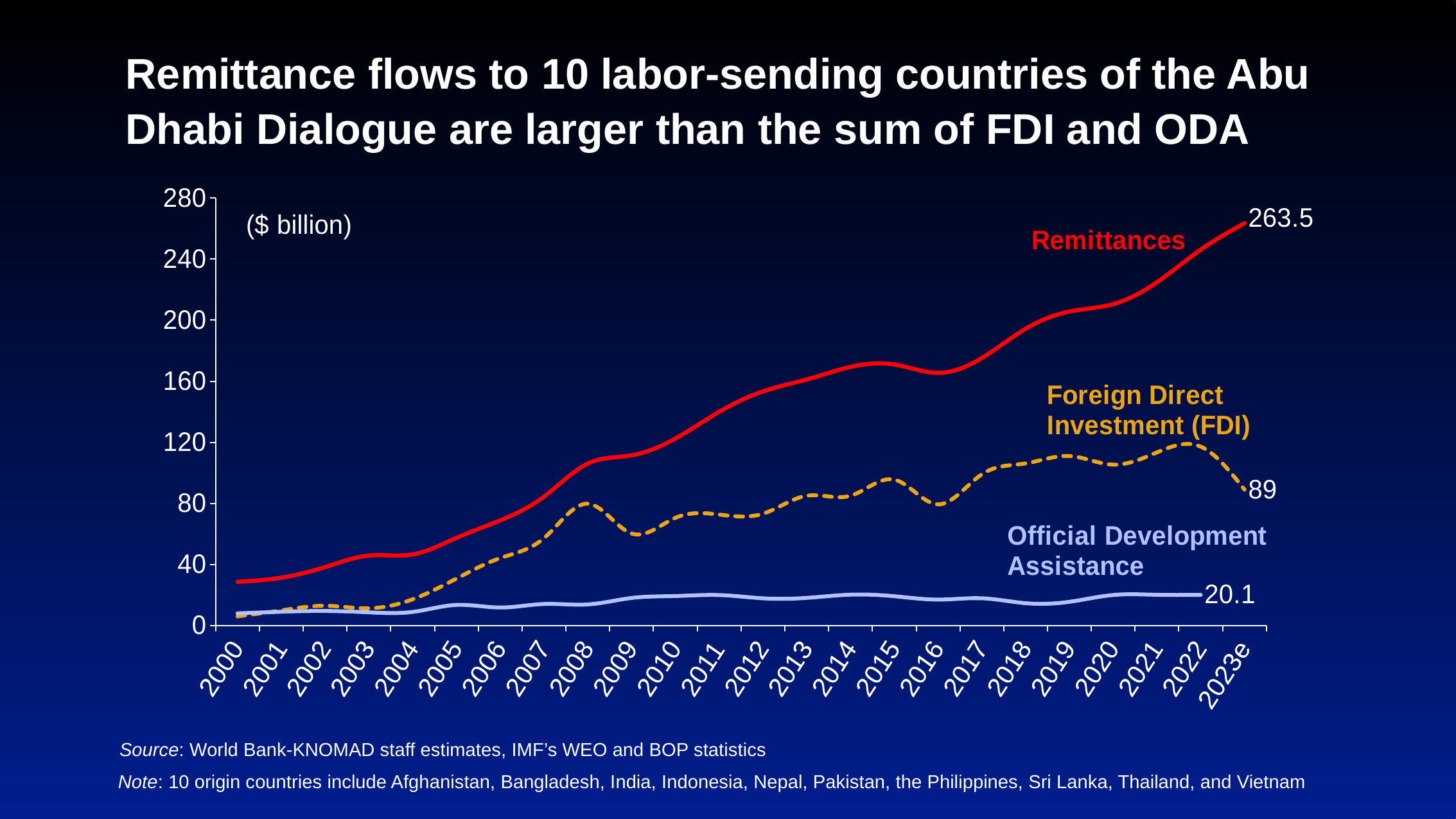
What kind of chart is shown on the slide? line chart What is the difference between Remittances and FDI in 2023e? 174.5 How many years are shown on the x axis? 24 Do Remittances generally rise or fall from 2000 to 2023e? rise What is the value of Foreign Direct Investment (FDI) in 2023e? 89 Is the value for Remittances in 2015 greater or less than 160? greater What is the value of Remittances in 2023e? 263.5 Which series has the highest value in 2023e? Remittances Is the value for Remittances in 2000 greater or less than 40? less